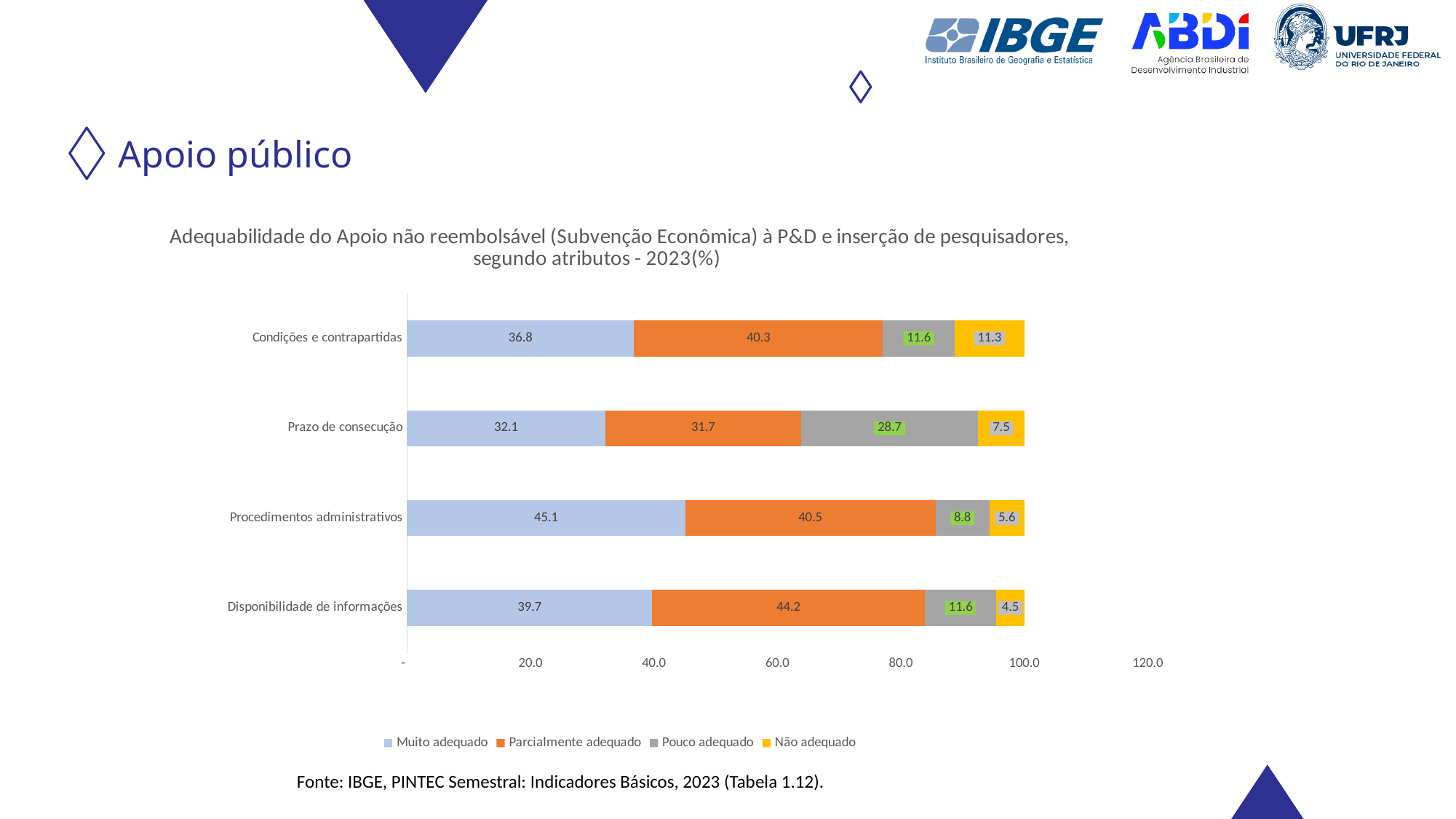
What is the total of the stacked bar for 'Procedimentos administrativos'? 100.0 What is the 'Não adequado' value for 'Disponibilidade de informações'? 4.5 Which is larger: the 'Não adequado' value for 'Condições e contrapartidas' or for 'Prazo de consecução'? Condições e contrapartidas How many series does the legend list? 4 What is the difference between the 'Parcialmente adequado' values for 'Disponibilidade de informações' and 'Prazo de consecução'? 12.5 How many categories (attributes) are plotted on the chart? 4 Which series is shown in orange in the legend? Parcialmente adequado What is the 'Muito adequado' value for 'Procedimentos administrativos'? 45.1 What kind of chart is shown on the slide? Stacked bar chart What is the 'Pouco adequado' value for 'Prazo de consecução'? 28.7 Which category has the lowest 'Não adequado' value? Disponibilidade de informações Which category has the highest 'Muito adequado' value? Procedimentos administrativos